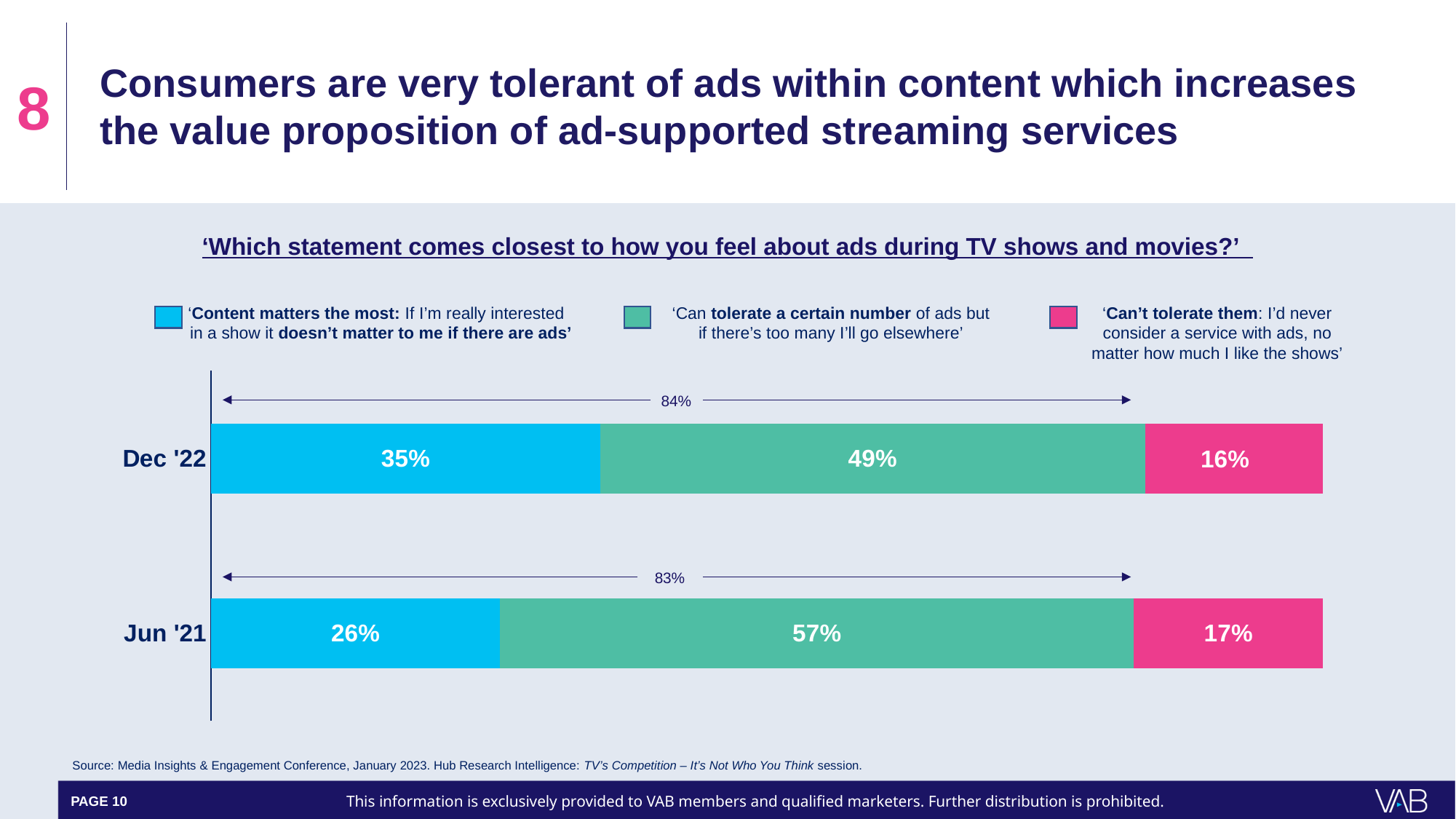
How many time periods are shown on the chart? 2 What percentage of respondents in Dec '22 said 'Content matters the most'? 35% Which response had the lowest share in Jun '21? Can't tolerate them Which period had the larger share for 'Can tolerate a certain number' of ads, Dec '22 or Jun '21? Jun '21 What percentage of respondents in Jun '21 said 'Content matters the most'? 26% What is the combined share of 'Content matters the most' and 'Can tolerate a certain number' for Dec '22, as shown by the bracket above the bar? 84% By how many percentage points did the 'Content matters the most' share change from Jun '21 to Dec '22? 9 percentage points How many series does the legend list? 3 Which response had the highest share in Dec '22? Can tolerate a certain number What percentage of respondents in Dec '22 said they 'Can't tolerate them'? 16% What percentage of respondents in Jun '21 said they 'Can tolerate a certain number' of ads? 57% What type of chart is shown on the slide? Stacked bar chart